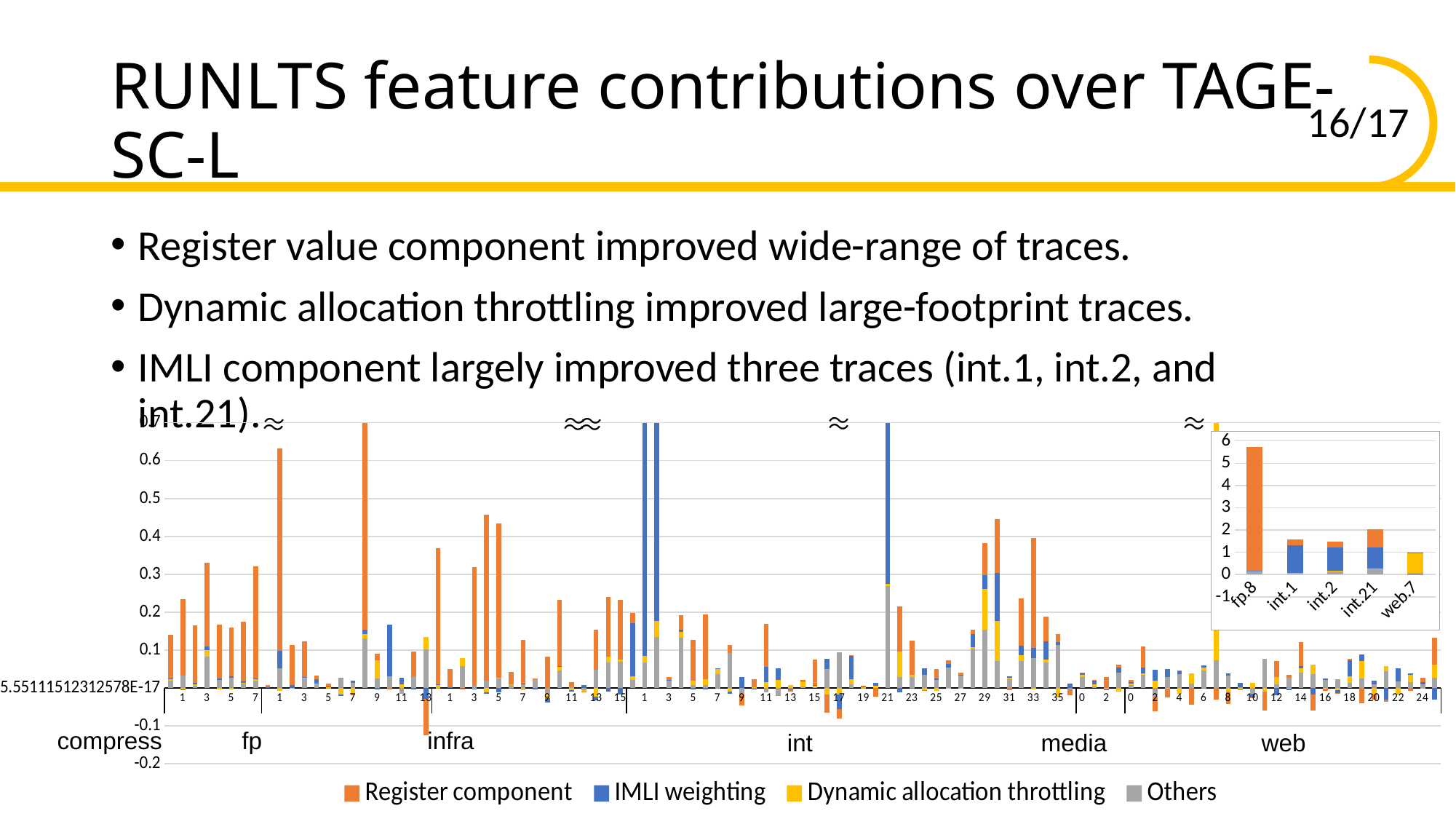
In the inset chart at the top right, which is larger, the total for fp.8 or the total for int.21? fp.8 What kind of chart is the large chart on the slide? Stacked bar chart In the inset chart at the top right, which series makes up almost all of the fp.8 bar? Register component In the inset chart at the top right, is the total for int.21 greater or less than 3? less In the inset chart at the top right, how many traces are shown on the x axis? 5 How many series does the legend of the large chart list? 4 How many benchmark groups are labelled along the x axis of the large chart (compress, fp, ...)? 6 In the inset chart at the top right, is the total for web.7 greater or less than 2? less In the inset chart at the top right, is the total for fp.8 greater or less than 5? greater In the inset chart at the top right, which trace has the lowest total bar? web.7 In the inset chart at the top right, which trace has the highest total bar? fp.8 In the large chart, which colour represents the IMLI weighting series? Blue